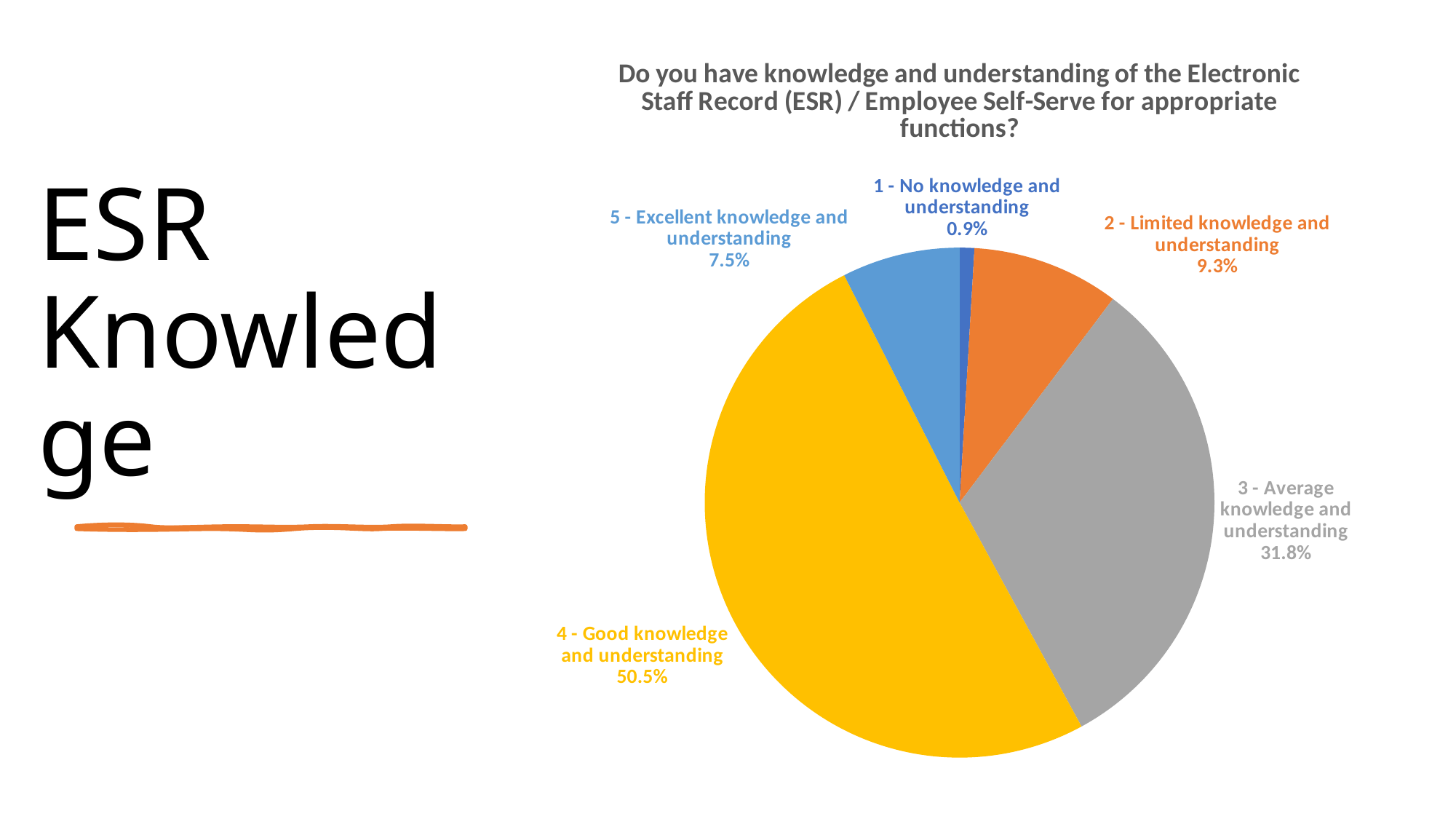
How many categories are shown in the pie chart? 5 Which is larger: the share for '2 - Limited knowledge and understanding' or '5 - Excellent knowledge and understanding'? 2 - Limited knowledge and understanding What percentage of respondents reported '4 - Good knowledge and understanding'? 50.5% What percentage of respondents reported '1 - No knowledge and understanding'? 0.9% What is the combined share of '1 - No knowledge and understanding' and '2 - Limited knowledge and understanding'? 10.2% What colour is the slice for '3 - Average knowledge and understanding'? Grey What percentage of respondents reported '5 - Excellent knowledge and understanding'? 7.5% What is the difference in percentage points between '4 - Good knowledge and understanding' and '3 - Average knowledge and understanding'? 18.7 Which category has the largest share of the pie? 4 - Good knowledge and understanding What percentage of respondents reported '3 - Average knowledge and understanding'? 31.8% What kind of chart is shown on the slide? Pie chart Which category has the smallest share of the pie? 1 - No knowledge and understanding